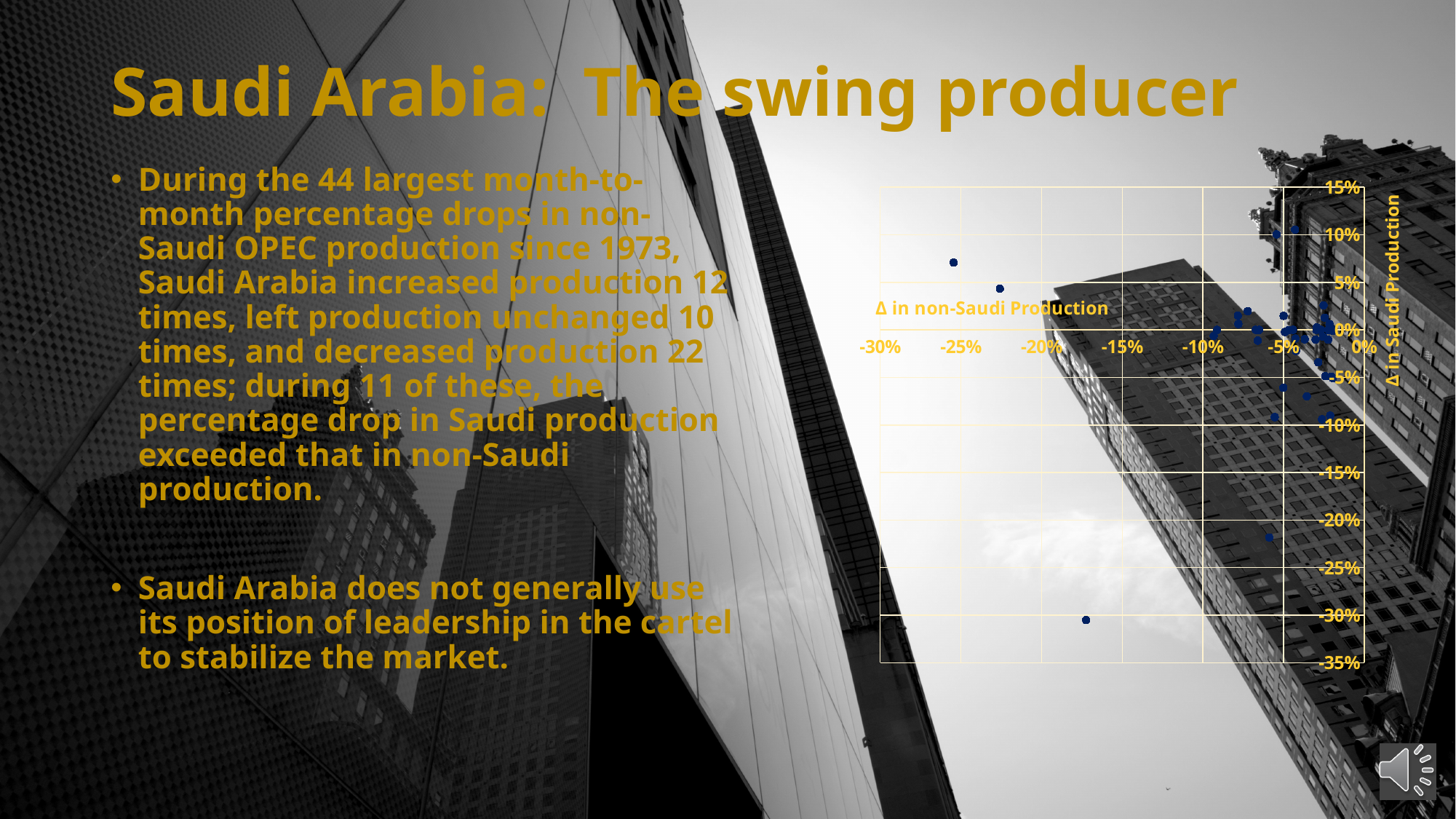
Is the Δ in Saudi Production value of the lowest point on the chart greater or less than -35%? greater Is the Δ in non-Saudi Production value of the lowest point on the chart greater or less than -20%? greater What is the label of the vertical axis of the chart? Δ in Saudi Production What kind of chart is shown on the slide? scatter chart Is the Δ in non-Saudi Production value of the leftmost point on the chart greater or less than -20%? less What is the label of the horizontal axis of the chart? Δ in non-Saudi Production